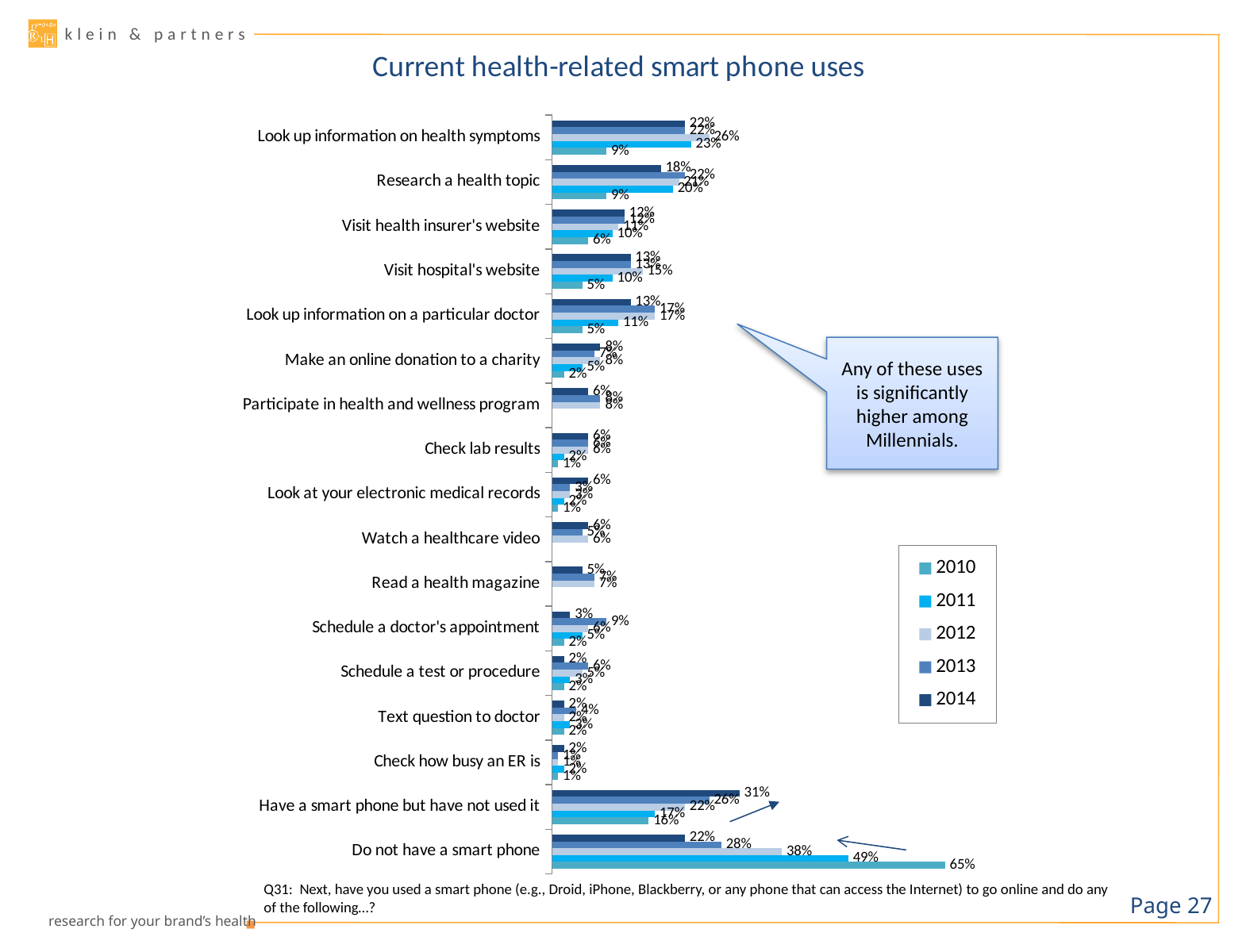
How many categories are plotted on the chart? 17 Which year has the highest value for 'Do not have a smart phone'? 2010 What is the 2010 value for 'Do not have a smart phone'? 65% How many series does the legend list? 5 What is the 2010 value for 'Look up information on health symptoms'? 9% What is the difference between the 2010 and 2014 values for 'Do not have a smart phone'? 43 percentage points What is the 2014 value for 'Do not have a smart phone'? 22% What is the 2014 value for 'Have a smart phone but have not used it'? 31% What kind of chart is shown on the slide? Bar chart For 'Do not have a smart phone', do the values rise or fall from 2010 to 2014? Fall What does the callout box on the chart say? Any of these uses is significantly higher among Millennials. What is the 2011 value for 'Do not have a smart phone'? 49%